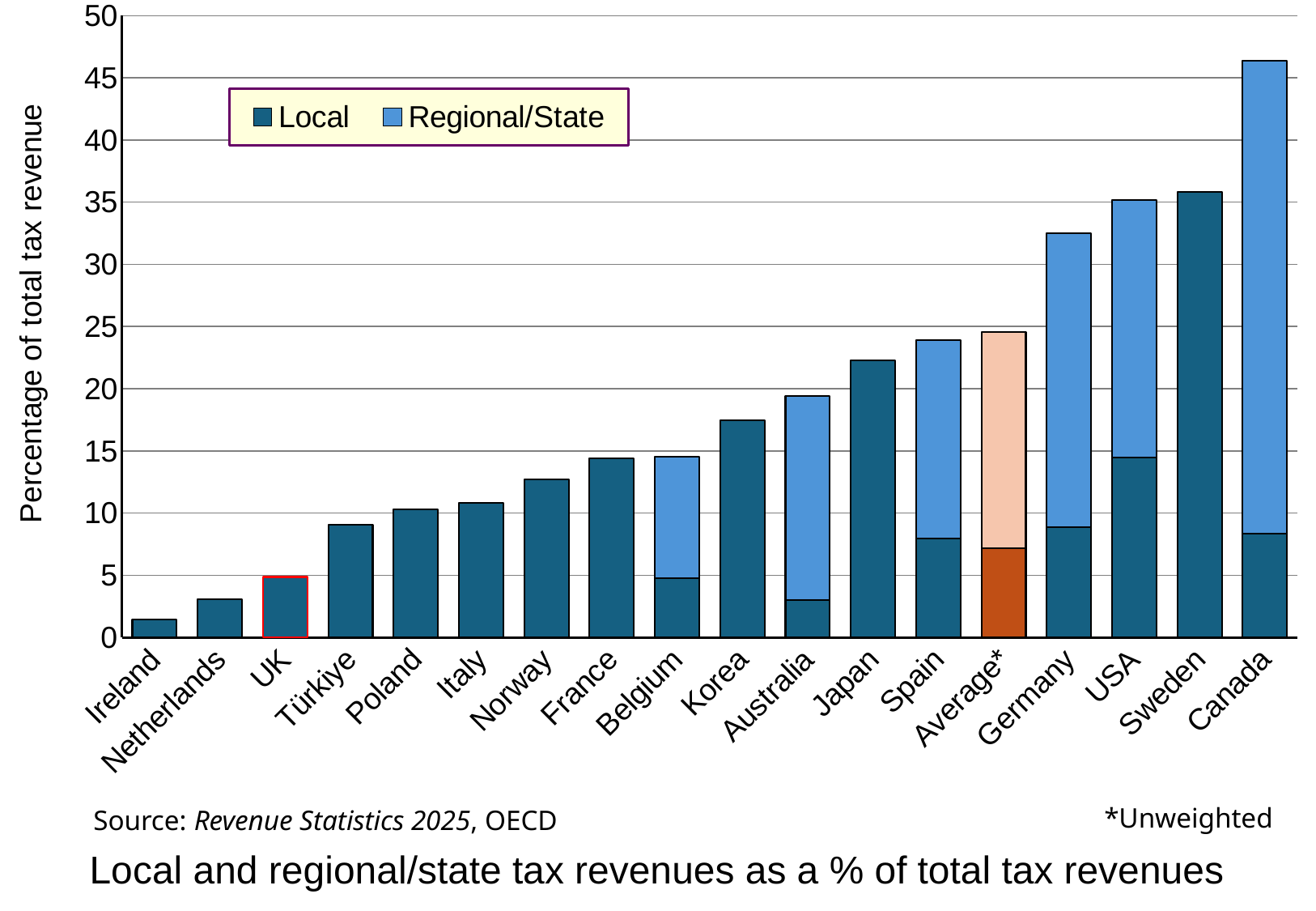
Is the value for Netherlands greater or less than 5? less Which category has the highest total bar? Canada How many countries/categories are shown along the x axis? 18 Do the total bar values generally rise or fall from left to right along the x axis? rise Is the total value for Canada greater or less than 45? greater Is the value for Korea greater or less than 20? less What kind of chart is shown on the slide? Stacked bar chart Which has the larger total bar, Sweden or Germany? Sweden How many series does the legend list? 2 Which category has the lowest total bar? Ireland What is the title of the chart? Local and regional/state tax revenues as a % of total tax revenues